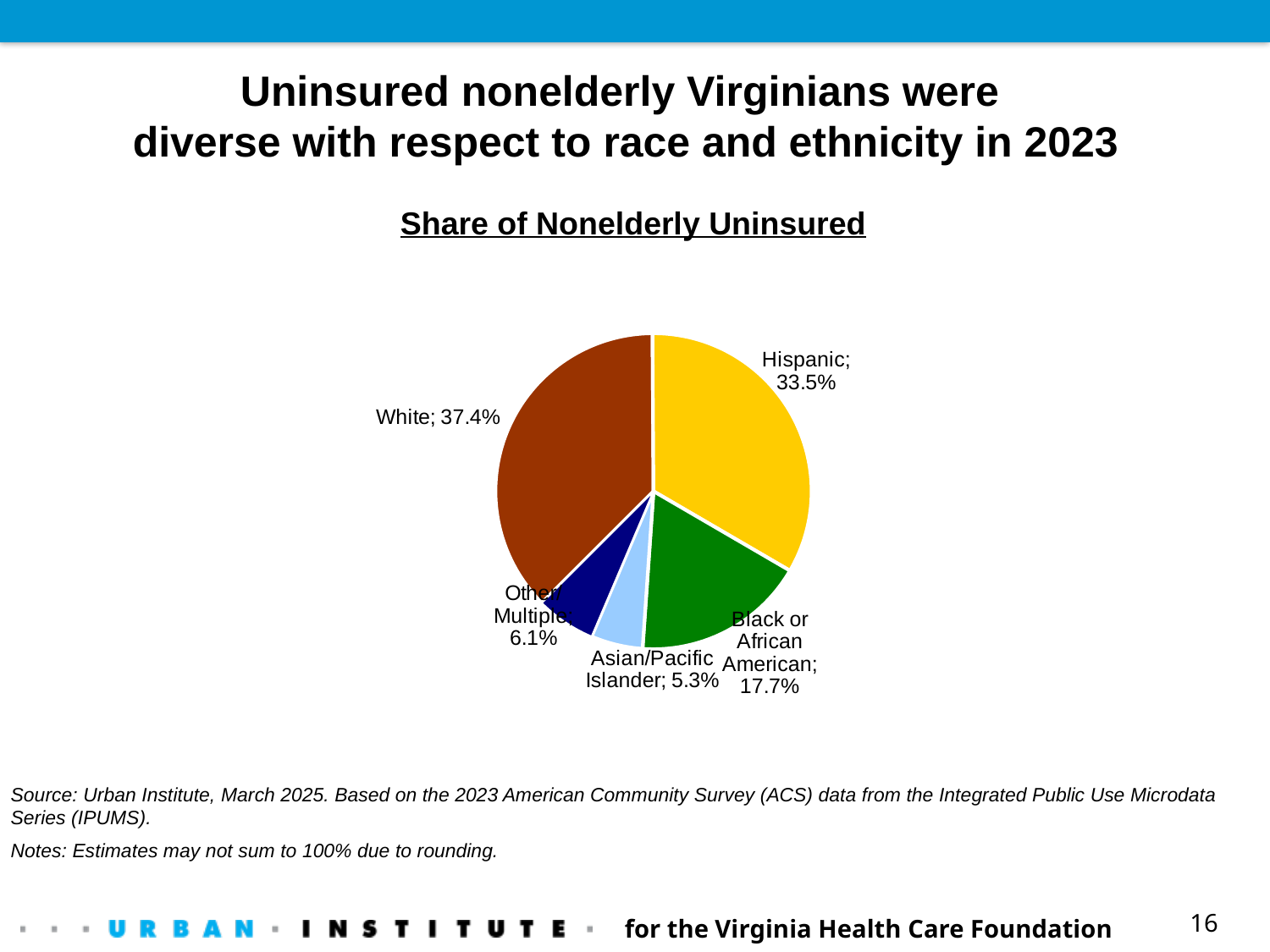
What share of nonelderly uninsured Virginians were Other/Multiple? 6.1% What share of nonelderly uninsured Virginians were Hispanic? 33.5% What is the title of the chart? Share of Nonelderly Uninsured What kind of chart is shown on the slide? Pie chart How many race/ethnicity categories are shown in the pie chart? 5 What share of nonelderly uninsured Virginians were Asian/Pacific Islander? 5.3% Which race/ethnicity group has the largest share of the nonelderly uninsured? White What share of nonelderly uninsured Virginians were Black or African American? 17.7% What share of nonelderly uninsured Virginians were White? 37.4% What is the difference in percentage points between the White share and the Hispanic share? 3.9 Which race/ethnicity group has the smallest share of the nonelderly uninsured? Asian/Pacific Islander Which is larger, the Black or African American share or the Other/Multiple share? Black or African American